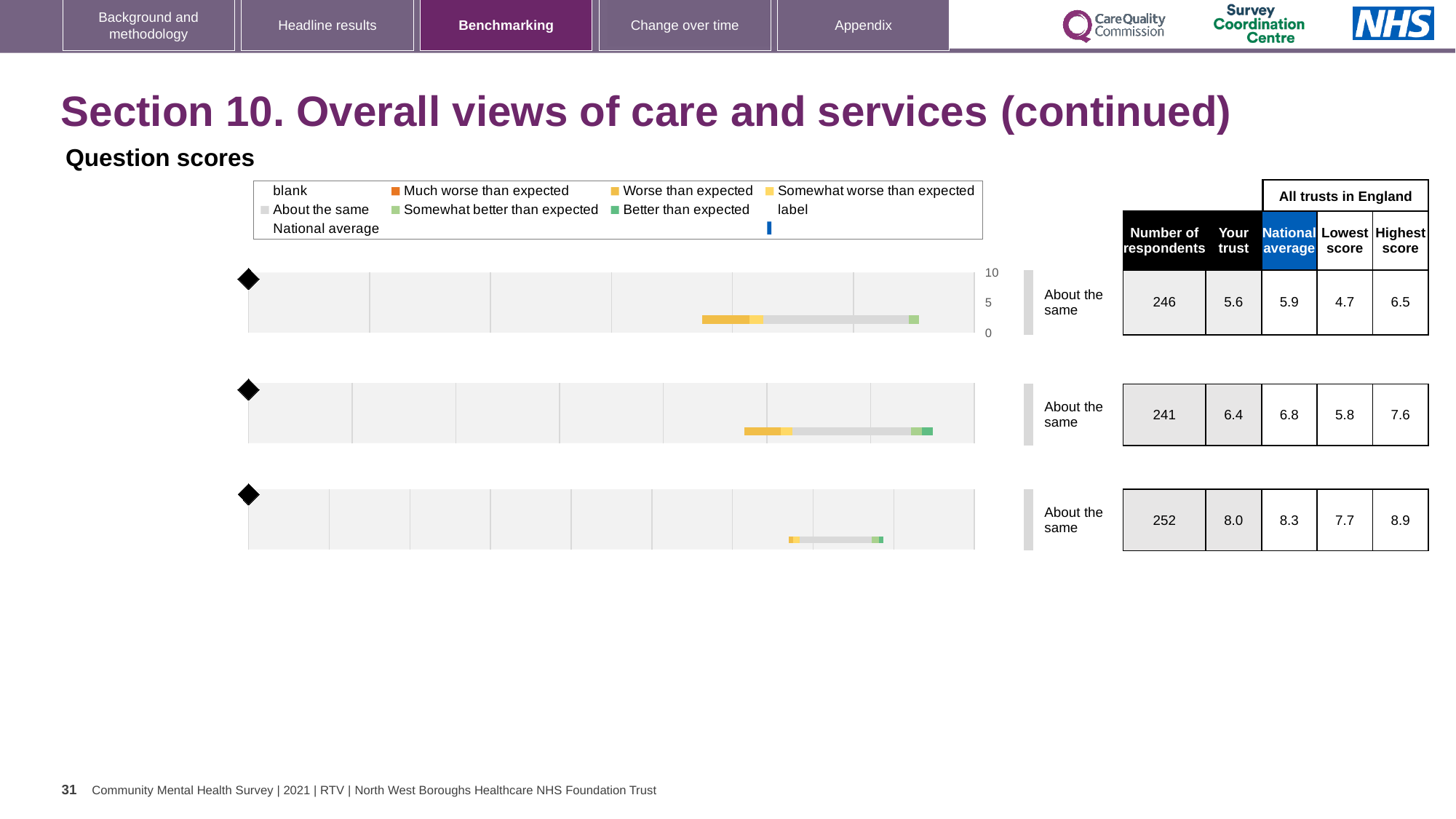
For the top chart, what is the 'Your trust' score? 5.6 For the middle chart, what is the national average score? 6.8 Which chart (top, middle or bottom) has the highest 'Your trust' score? bottom What kind of chart is used to show the question scores on this slide? bar chart For the middle chart, how much higher is the national average than the 'Your trust' score? 0.4 Which chart (top, middle or bottom) has the lowest number of respondents? middle How many question score charts are shown on the slide? 3 For the bottom chart, what is the difference between the highest score and the lowest score? 1.2 What benchmark category label is shown next to each of the three charts? About the same For the top chart, which is larger: the 'Your trust' score or the national average? National average For the bottom chart, how many respondents are there? 252 For the top chart, what is the lowest score among all trusts in England? 4.7